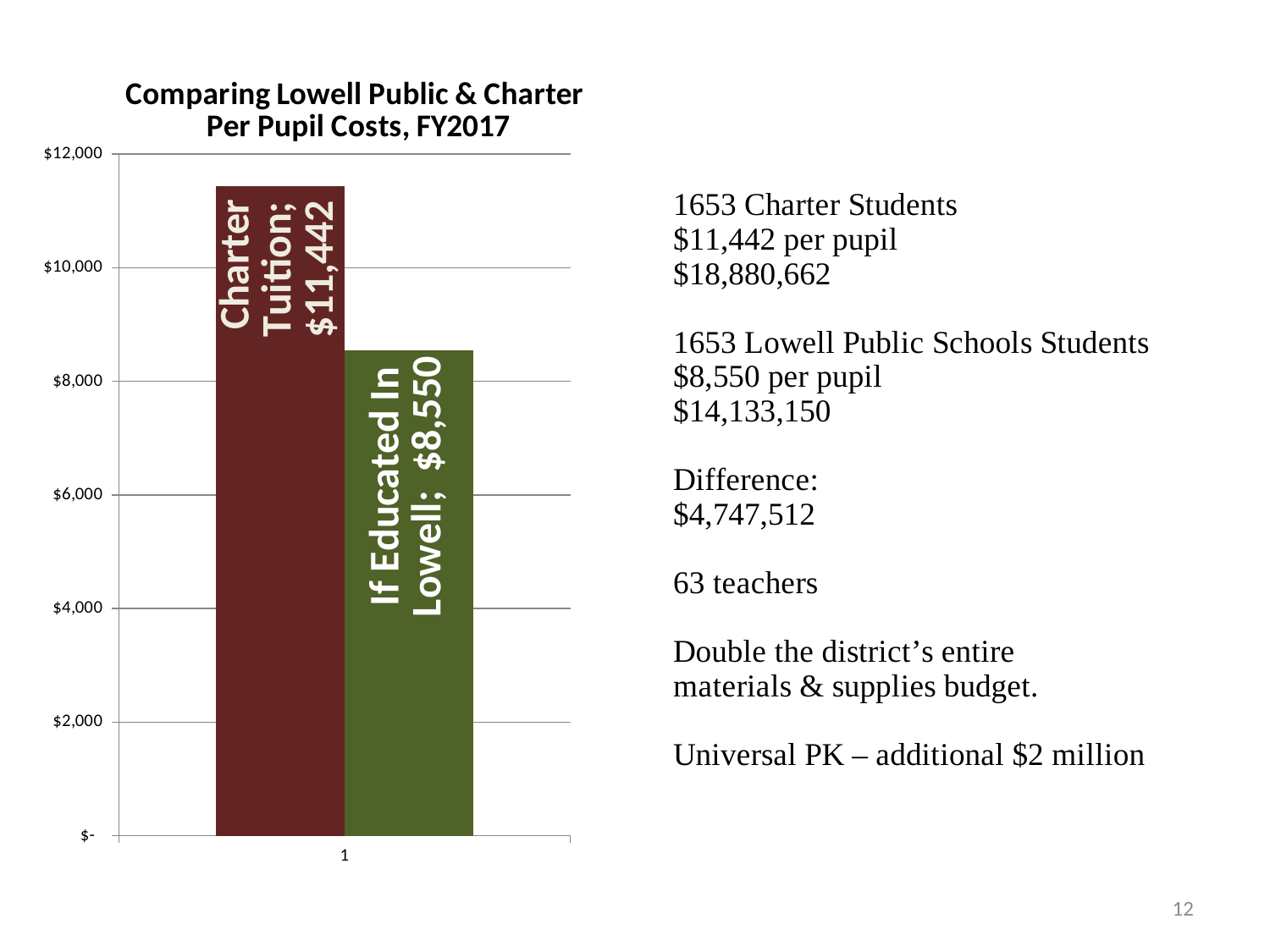
Is the value for Charter Tuition greater or less than $10,000? greater What is the title of the chart? Comparing Lowell Public & Charter Per Pupil Costs, FY2017 What kind of chart is shown on the slide? Bar chart What is the value for Charter Tuition? $11,442 Which series has the highest value? Charter Tuition What is the difference between Charter Tuition and If Educated In Lowell? $2,892 What is the highest value shown on the vertical axis? $12,000 How many bars are plotted on the chart? 2 What is the value for If Educated In Lowell? $8,550 Which series has the lowest value? If Educated In Lowell Is the value for If Educated In Lowell greater or less than $10,000? less Which bar is higher, Charter Tuition or If Educated In Lowell? Charter Tuition